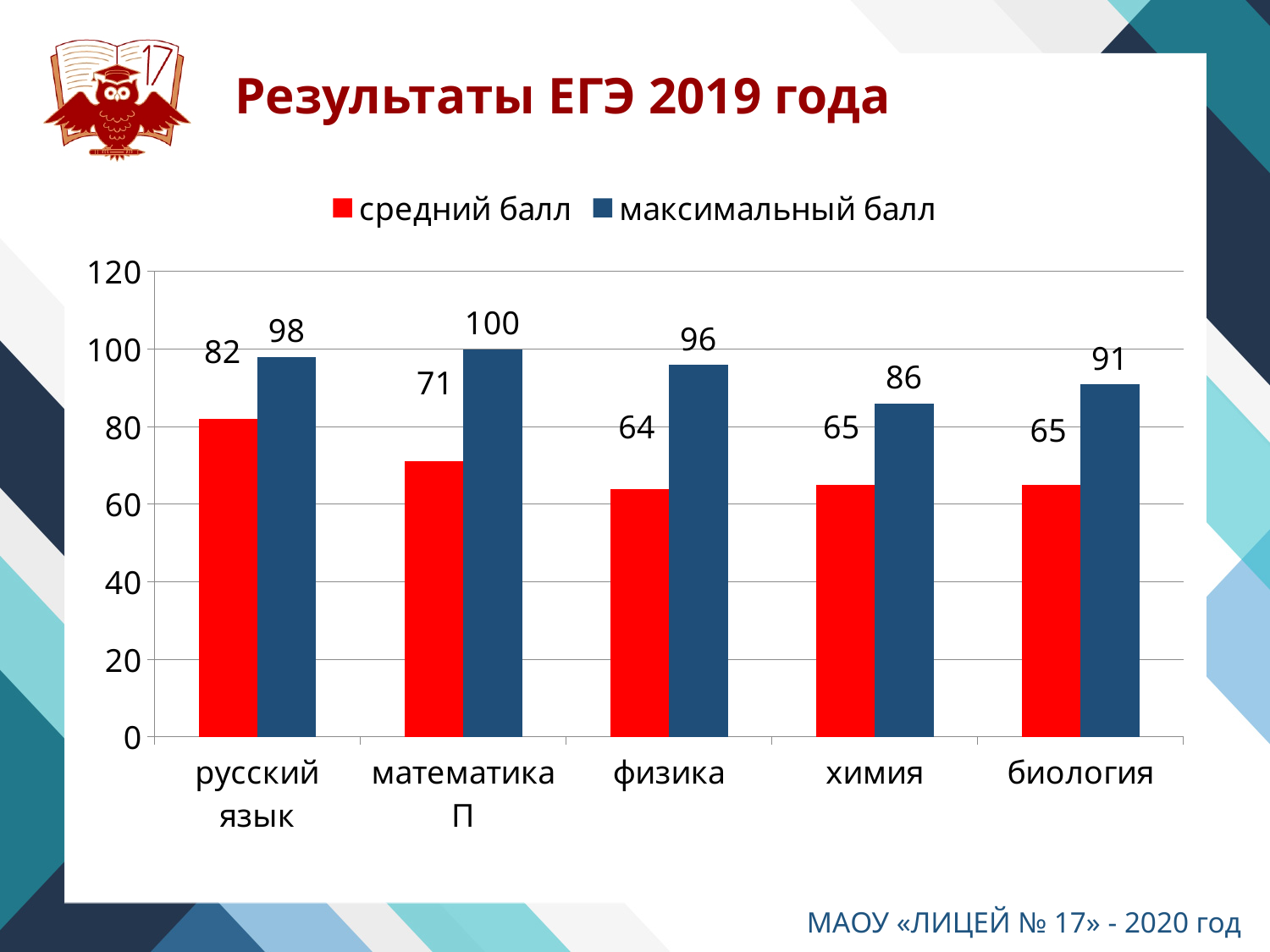
What kind of chart is shown on the slide? bar chart How many series does the legend list? 2 Which subject has the lowest максимальный балл? химия Which is larger: the средний балл for математика П or the средний балл for биология? математика П How many subjects are shown on the x axis? 5 What is the средний балл for физика? 64 What is the difference between the максимальный балл and the средний балл for химия? 21 What is the максимальный балл for математика П? 100 What is the средний балл for русский язык? 82 Which subject has the highest средний балл? русский язык What colour are the bars for средний балл? red Is the максимальный балл for биология greater or less than 80? greater